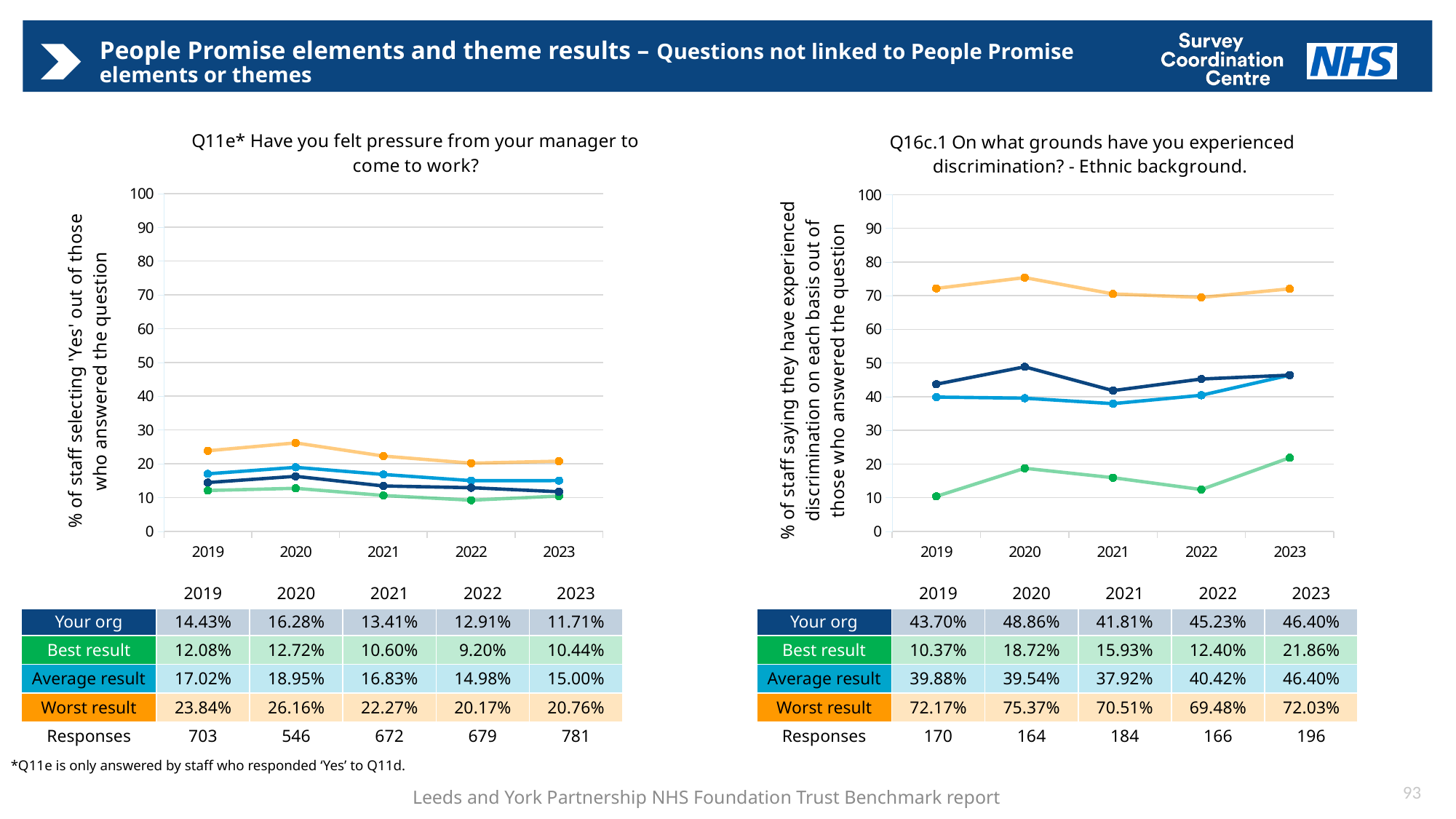
How many series are plotted in the Q16c.1 chart? 4 In the Q11e chart, does the 'Your org' value rise or fall from 2020 to 2023? Fall In the Q11e chart, what was the 'Your org' value in 2020? 16.28% In the Q16c.1 chart, which is larger in 2022: 'Your org' or 'Average result'? Your org In the Q16c.1 chart, in which year was the 'Best result' value lowest? 2019 In the Q11e chart, what is the difference between the 'Worst result' and 'Your org' values in 2023? 9.05% What type of chart is used for Q11e? Line chart In the Q16c.1 chart, what was the 'Worst result' value in 2021? 70.51% In the Q16c.1 chart, is the 'Worst result' value for 2020 greater or less than 70? greater How many responses were recorded for the Q16c.1 question in 2023? 196 How many years are plotted on the x axis of the Q11e chart? 5 In the Q11e chart, in which year was the 'Your org' value highest? 2020